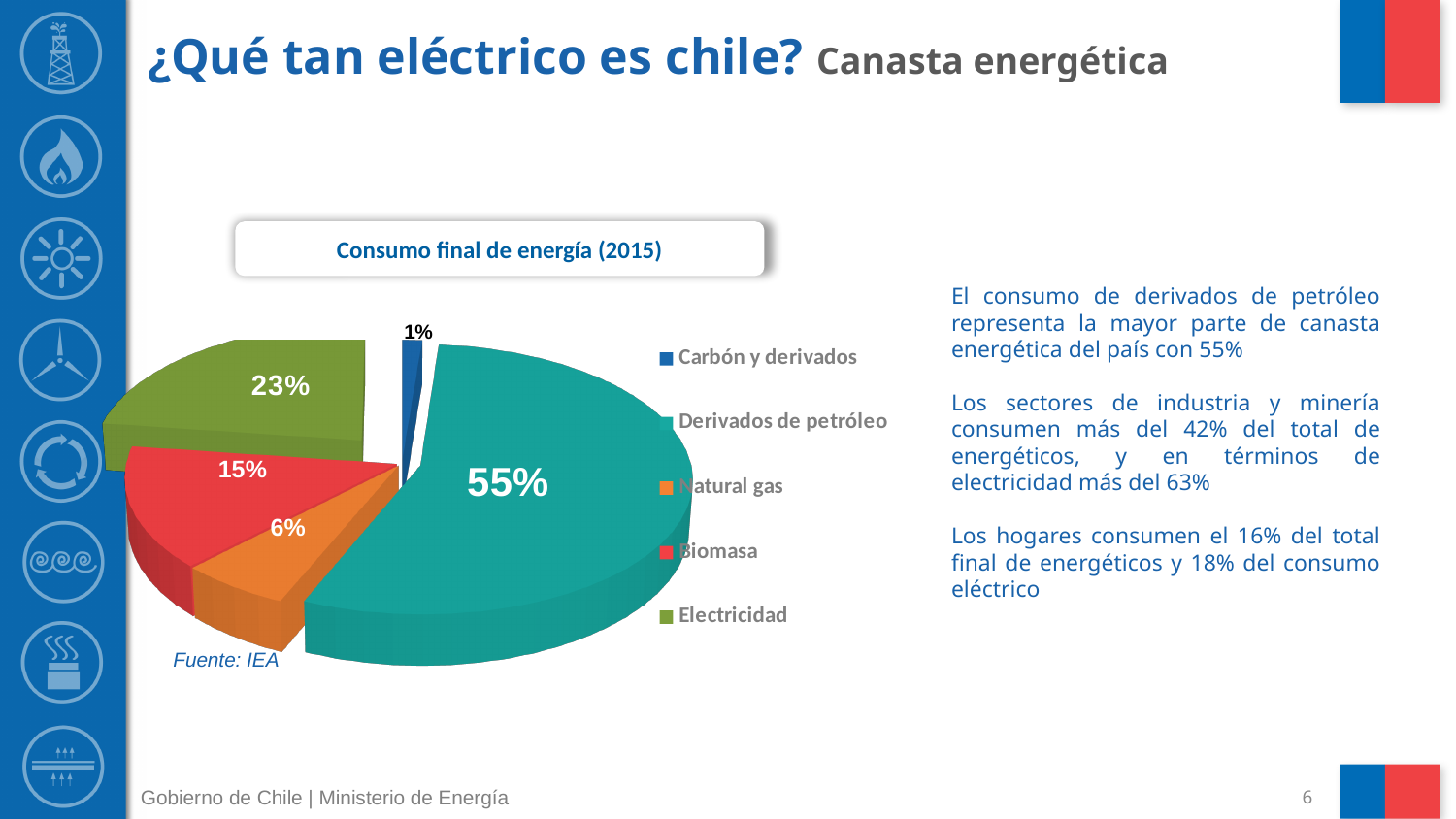
What share of final energy consumption does Natural gas represent? 6% What is the difference in percentage points between Electricidad and Biomasa? 8 Which category has the smallest share of the pie? Carbón y derivados How many categories does the legend list? 5 What share of final energy consumption does Biomasa represent? 15% What kind of chart is shown on the slide? Pie chart What share of final energy consumption does Electricidad represent? 23% Which category has the largest share of the pie? Derivados de petróleo Which is larger, the share for Biomasa or the share for Natural gas? Biomasa What share of final energy consumption does Carbón y derivados represent? 1% What is the title of the chart? Consumo final de energía (2015) What share of final energy consumption does Derivados de petróleo represent? 55%